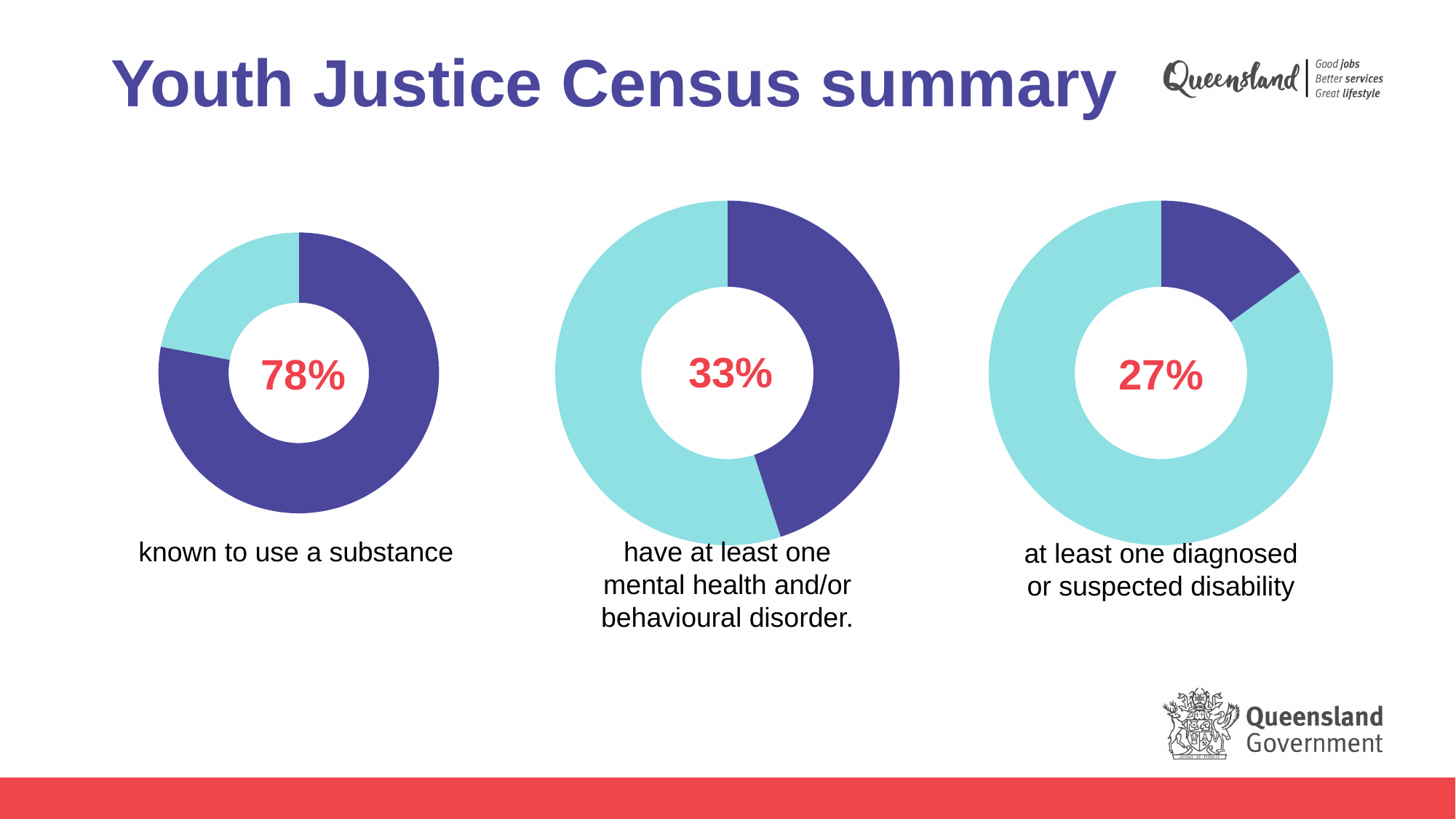
How many donut charts are shown on the slide? 3 What kind of chart is used to display the percentages on this slide? donut chart What percentage is shown in the donut chart labelled "known to use a substance"? 78% Which of the three donut charts shows the highest percentage? known to use a substance What is the difference in percentage points between the "known to use a substance" chart and the "at least one diagnosed or suspected disability" chart? 51 What is the difference in percentage points between the mental health and/or behavioural disorder chart and the diagnosed or suspected disability chart? 6 What percentage is shown in the donut chart labelled "at least one diagnosed or suspected disability"? 27% What percentage is shown in the donut chart labelled "have at least one mental health and/or behavioural disorder"? 33% Which of the three donut charts shows the lowest percentage? at least one diagnosed or suspected disability In the "known to use a substance" chart, what share of the ring is coloured dark purple? 78% Is the percentage shown in the "known to use a substance" chart greater or less than 50%? greater Which is larger: the percentage for "known to use a substance" or the percentage for "have at least one mental health and/or behavioural disorder"? known to use a substance